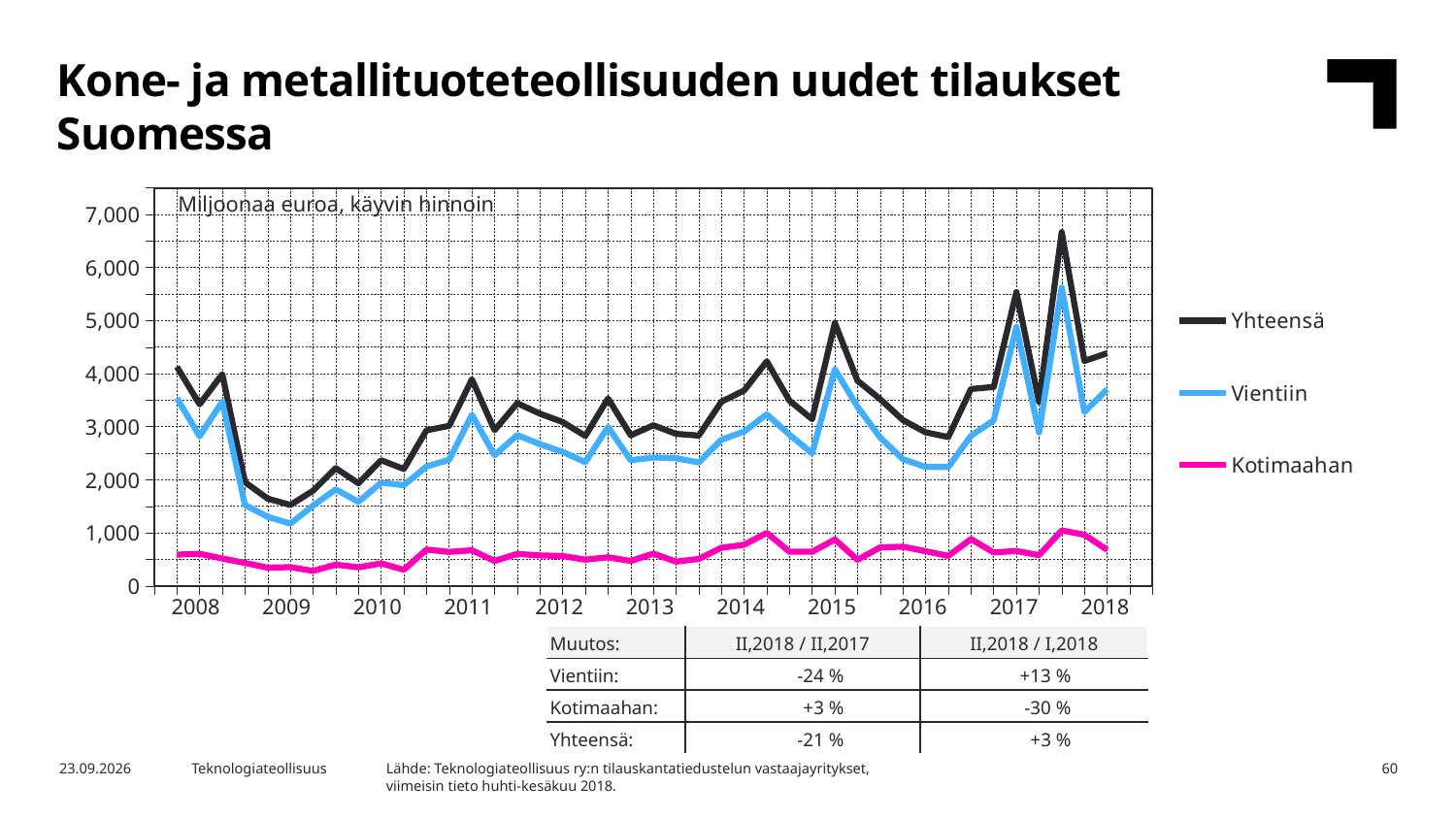
How many series does the chart legend list? 3 Did the Yhteensä series rise or fall from the start of 2008 to the start of 2009? fall What kind of chart is shown on the slide? line chart Which series has the highest values across the whole period? Yhteensä In which year does the Yhteensä series reach its highest peak? 2017 How many years are labeled on the x axis? 11 Is the highest peak of the Vientiin series greater or less than 5,000? greater Is the highest peak of the Yhteensä series greater or less than 6,000? greater Which series has the lowest values across the whole period? Kotimaahan What are the three series named in the chart legend? Yhteensä, Vientiin, Kotimaahan What unit label is printed inside the chart area? Miljoonaa euroa, käyvin hinnoin Is the highest value of the Kotimaahan series greater or less than 2,000? less